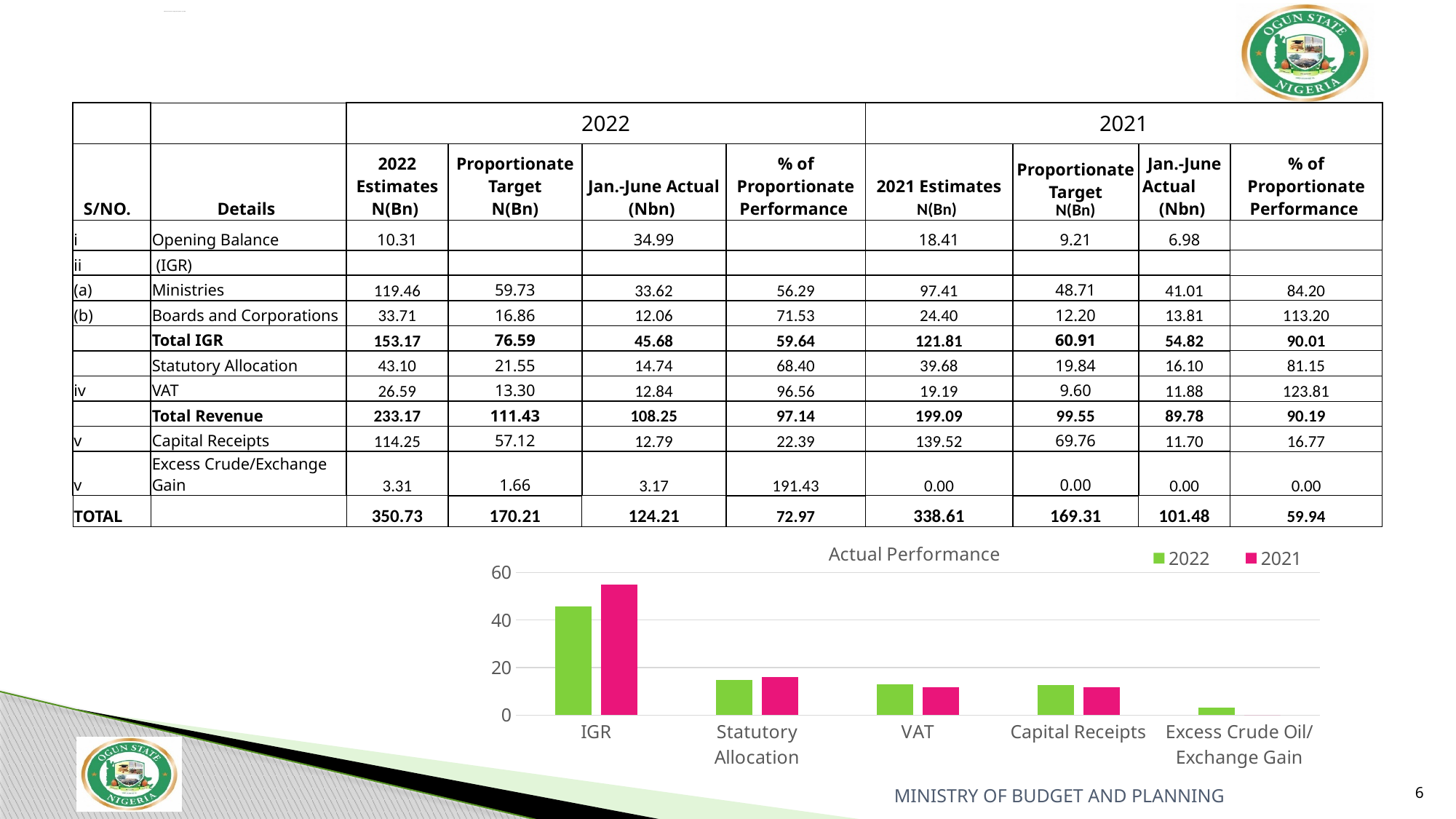
What is the title of the chart? Actual Performance How many categories are shown on the x axis of the chart? 5 What kind of chart is shown on the slide? bar chart For Excess Crude Oil/ Exchange Gain, which series has the larger value, 2022 or 2021? 2022 Is the 2021 value for IGR greater or less than 40? greater How many series does the chart legend list? 2 Which colour represents the 2022 series in the chart? green Which category has the lowest value for the 2022 series? Excess Crude Oil/ Exchange Gain For IGR, which series has the larger value, 2022 or 2021? 2021 Which category has the highest value for the 2022 series? IGR Is the 2022 value for Statutory Allocation greater or less than 20? less Which category has the highest value for the 2021 series? IGR